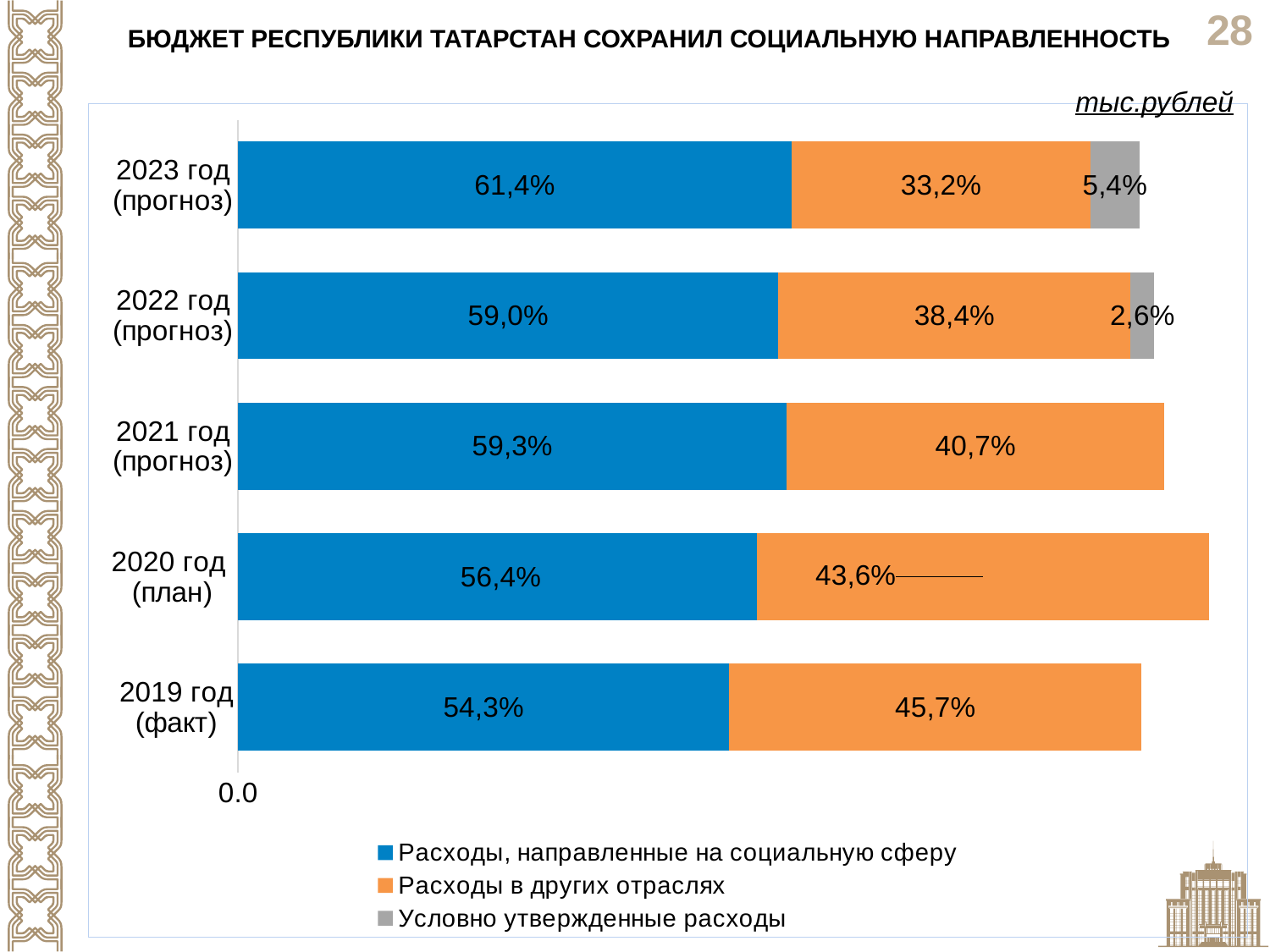
What unit label is shown above the chart? тыс.рублей Which is larger: the share of expenditures in other sectors for 2020 год (план) or for 2022 год (прогноз)? 2020 год (план) What is the share of expenditures in other sectors (Расходы в других отраслях) for 2019 год (факт)? 45,7% What is the share of expenditures directed to the social sphere (Расходы, направленные на социальную сферу) for 2023 год (прогноз)? 61,4% What is the share of expenditures in other sectors (Расходы в других отраслях) for 2021 год (прогноз)? 40,7% By how many percentage points does the social sphere share for 2023 год (прогноз) exceed that for 2019 год (факт)? 7,1 Which year has the lowest share of expenditures directed to the social sphere? 2019 год (факт) How many series does the legend list? 3 How many year categories are shown in the chart? 5 What kind of chart is shown on the slide? Stacked bar chart Which year has the highest share of expenditures directed to the social sphere? 2023 год (прогноз) What is the share of conditionally approved expenditures (Условно утвержденные расходы) for 2022 год (прогноз)? 2,6%